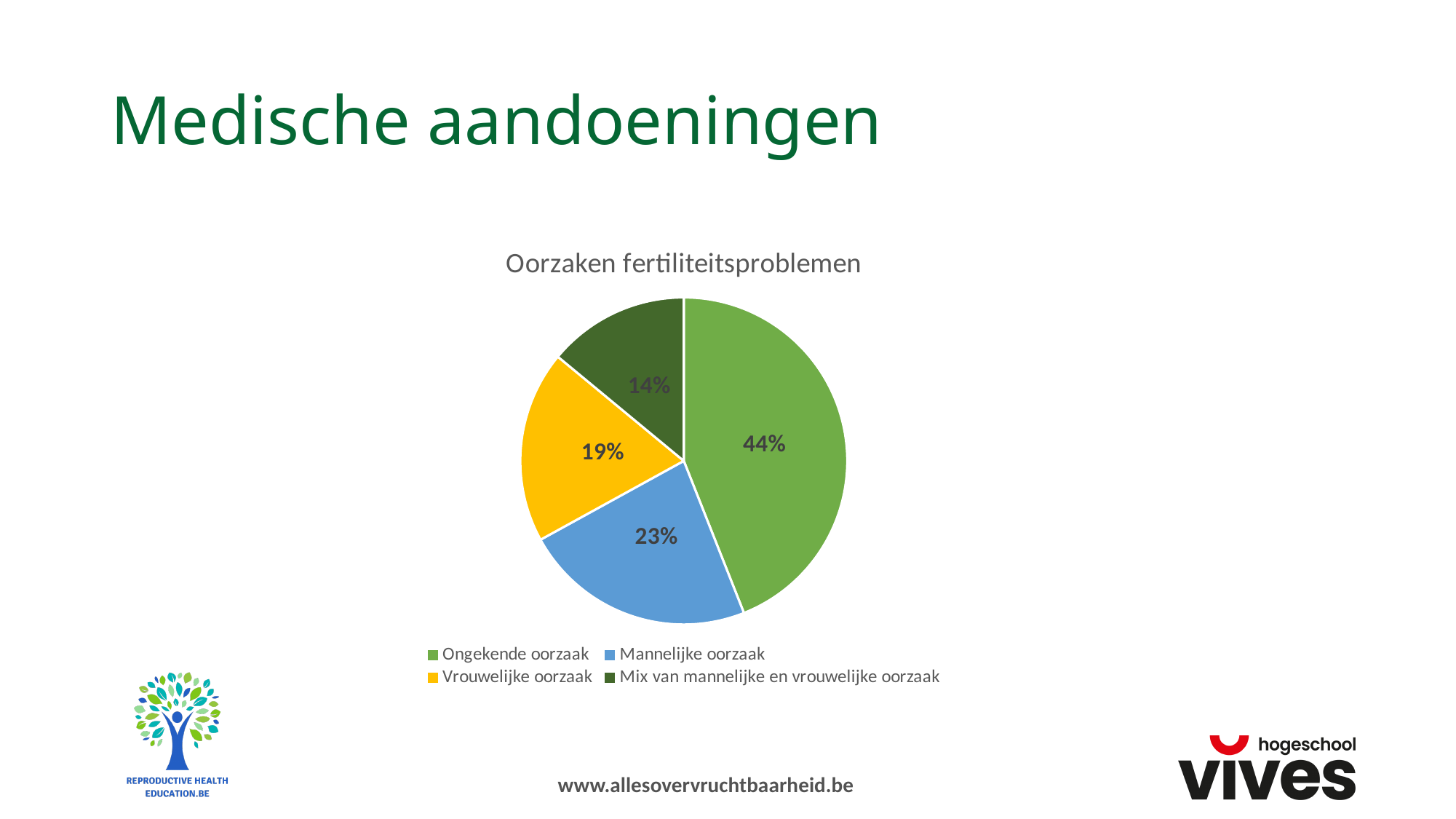
What share of the pie is Ongekende oorzaak? 44% What share of the pie is Vrouwelijke oorzaak? 19% Which is larger, the share of Mannelijke oorzaak or the share of Vrouwelijke oorzaak? Mannelijke oorzaak What share of the pie is Mix van mannelijke en vrouwelijke oorzaak? 14% What is the title of the chart? Oorzaken fertiliteitsproblemen Which category has the smallest slice of the pie? Mix van mannelijke en vrouwelijke oorzaak Which category has the largest slice of the pie? Ongekende oorzaak What kind of chart is shown on the slide? pie chart What colour is the slice for Vrouwelijke oorzaak? yellow What is the difference between the shares of Ongekende oorzaak and Mannelijke oorzaak? 21% How many slices does the pie chart have? 4